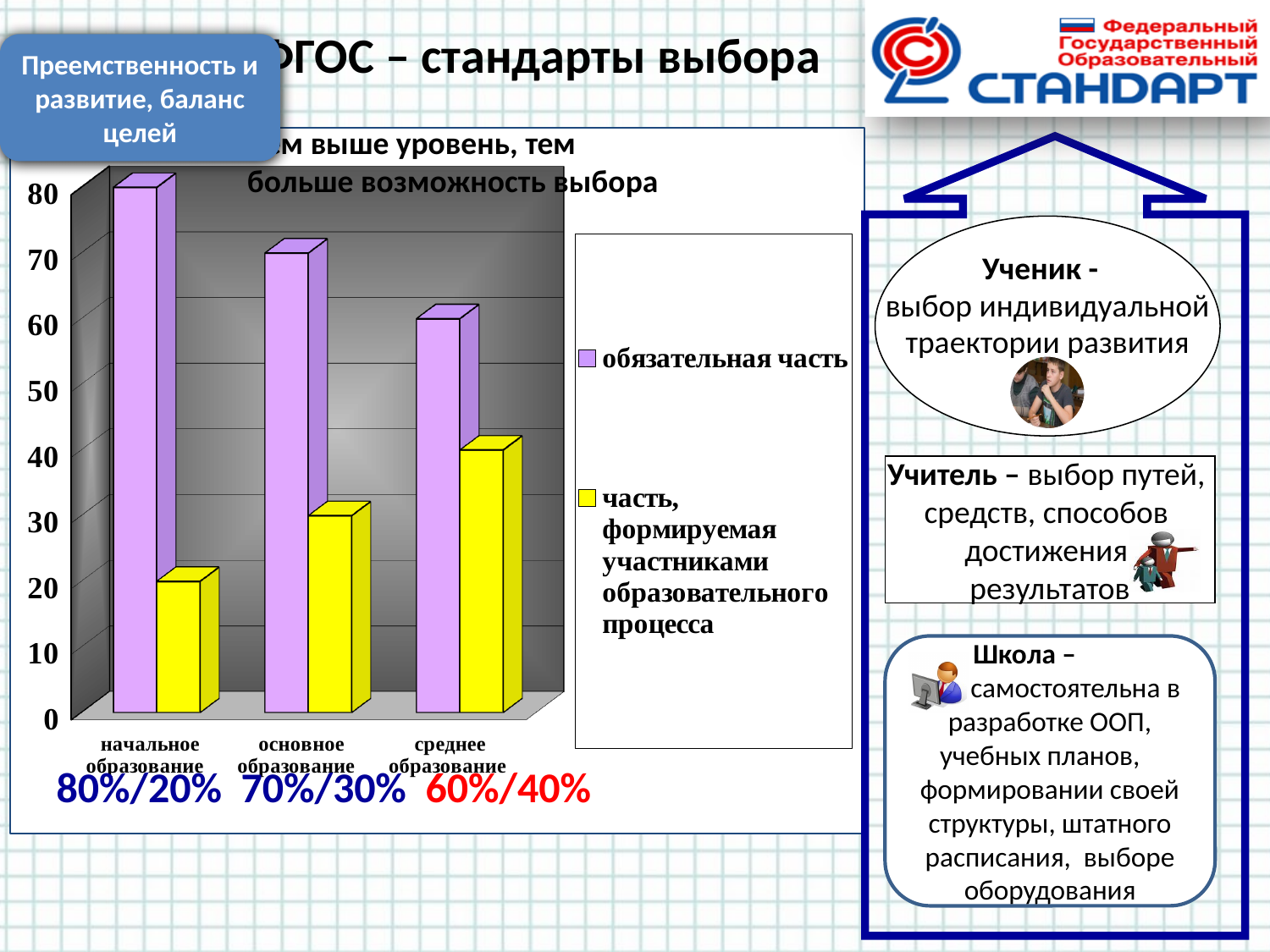
What kind of chart is shown on the slide? bar chart What is the value of 'обязательная часть' for 'начальное образование'? 80% How many series does the chart legend list? 2 What is the difference between 'обязательная часть' and 'часть, формируемая участниками образовательного процесса' for 'начальное образование'? 60% Which category has the highest value for 'обязательная часть'? начальное образование Which category has the lowest value for 'часть, формируемая участниками образовательного процесса'? начальное образование For 'среднее образование', which is larger: 'обязательная часть' or 'часть, формируемая участниками образовательного процесса'? обязательная часть What is the value of 'часть, формируемая участниками образовательного процесса' for 'среднее образование'? 40% How many education-level categories are shown on the x axis of the chart? 3 What colour are the bars for 'обязательная часть' in the chart? purple What is the value of 'часть, формируемая участниками образовательного процесса' for 'основное образование'? 30% Does the value of 'обязательная часть' rise or fall from 'начальное образование' to 'среднее образование'? fall